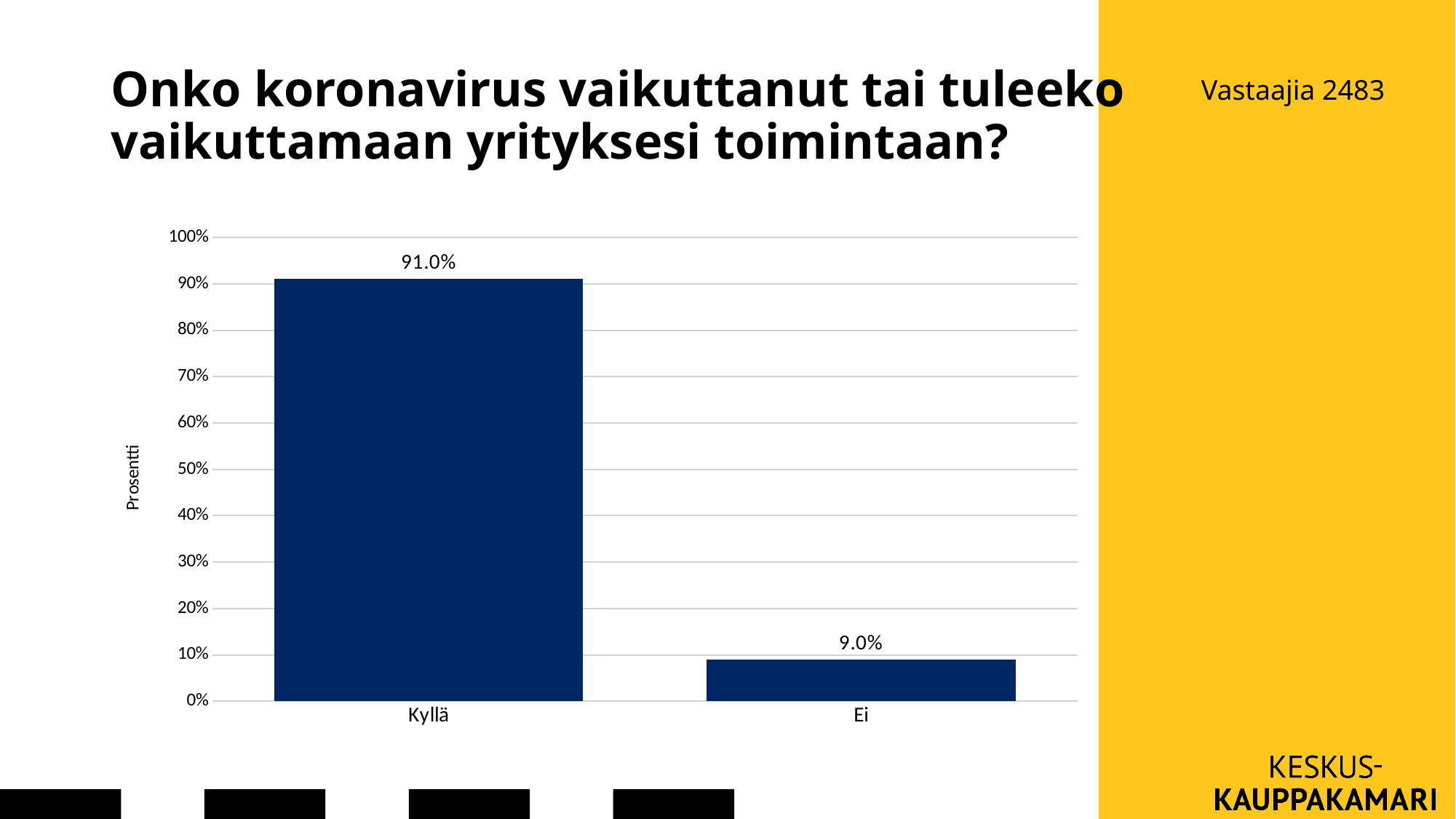
What is the difference between the values for Kyllä and Ei? 82.0% What is the value for Kyllä? 91.0% Is the value for Kyllä greater or less than 80%? greater How many categories are shown on the x axis? 2 What is the total of the values for Kyllä and Ei? 100.0% What is the label of the y axis? Prosentti Is the value for Ei greater or less than 20%? less What is the value for Ei? 9.0% Which category has the lowest value? Ei Which category has the highest value? Kyllä What kind of chart is shown on the slide? bar chart Which is larger, the value for Kyllä or the value for Ei? Kyllä